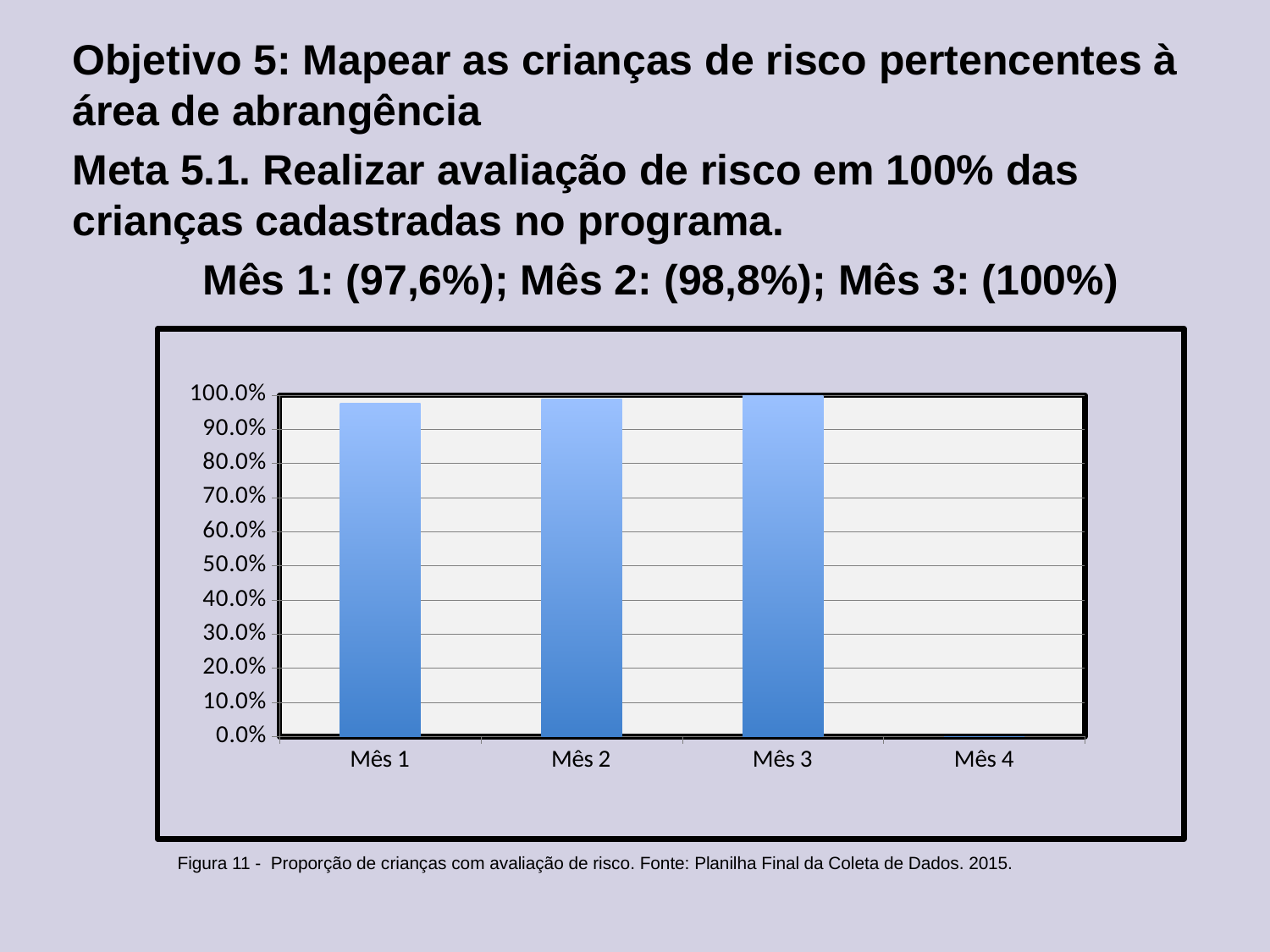
What is the value for Mês 1? 97,6% Which is larger, the value for Mês 1 or the value for Mês 2? Mês 2 Which month has no visible bar in the chart? Mês 4 Is the value for Mês 1 greater or less than 90.0%? greater What is the value for Mês 3? 100% Which month has the highest value in the chart? Mês 3 What is the difference between the values for Mês 3 and Mês 1? 2,4 percentage points Do the values rise or fall from Mês 1 to Mês 3? rise What is the difference between the values for Mês 2 and Mês 1? 1,2 percentage points What is the value for Mês 2? 98,8% How many categories are shown on the x axis of the chart? 4 What kind of chart is shown on the slide? bar chart